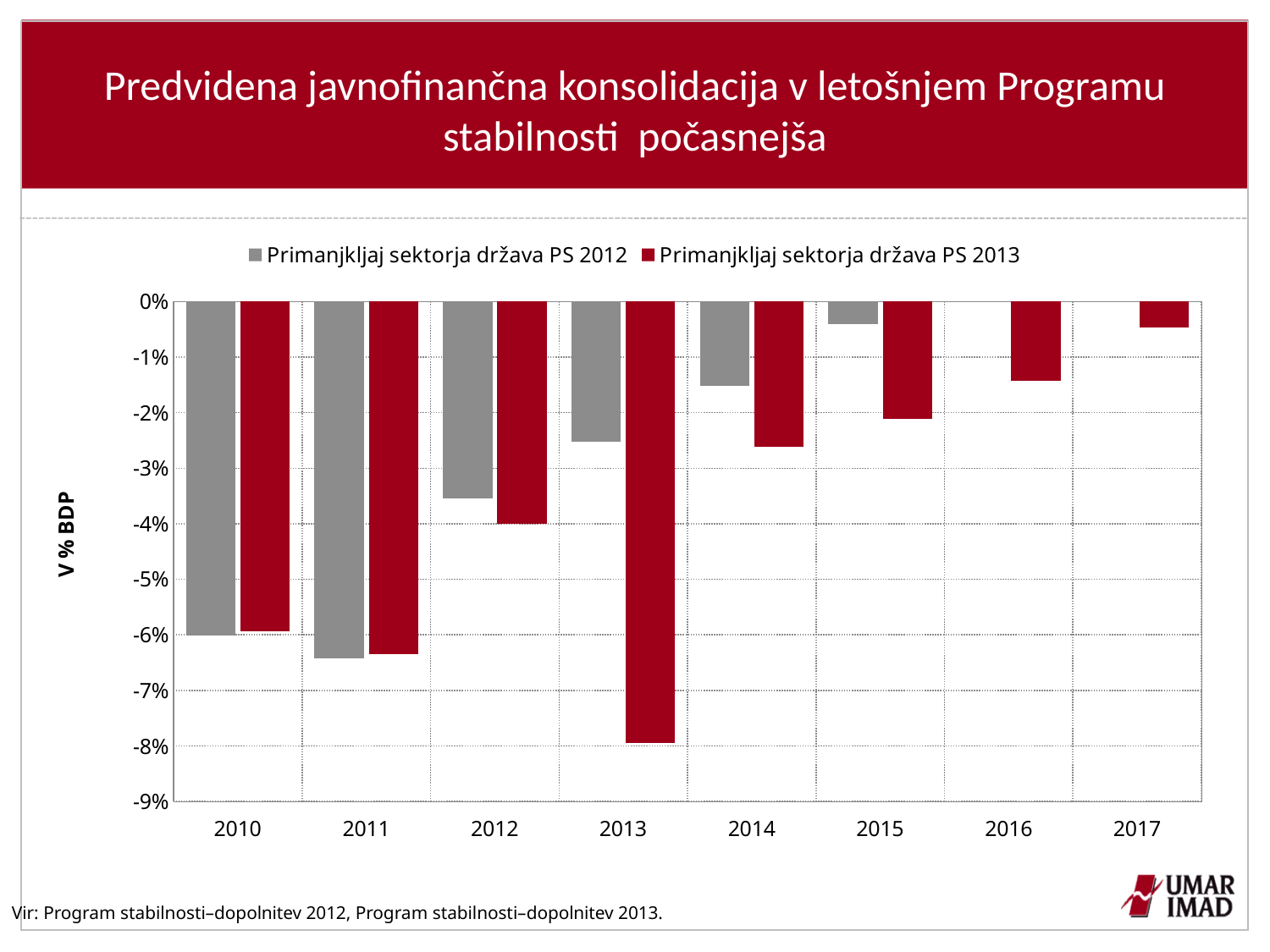
For how many years is a Primanjkljaj sektorja država PS 2012 bar plotted? 6 What kind of chart is shown on the slide? bar chart In which year is the Primanjkljaj sektorja država PS 2013 bar the longest (largest deficit)? 2013 Is the Primanjkljaj sektorja država PS 2013 value for 2013 greater or less than -7%? less In which year is the Primanjkljaj sektorja država PS 2013 bar the shortest (smallest deficit)? 2017 In 2013, which series shows the larger deficit, PS 2012 or PS 2013? Primanjkljaj sektorja država PS 2013 How many series does the legend list? 2 What is the label on the vertical axis? V % BDP In which year is the Primanjkljaj sektorja država PS 2012 bar the shortest (smallest deficit)? 2015 From 2013 to 2017, does the deficit in the Primanjkljaj sektorja država PS 2013 series shrink or grow? shrink Is the Primanjkljaj sektorja država PS 2012 value for 2015 greater or less than -1%? greater How many years are shown on the x axis? 8